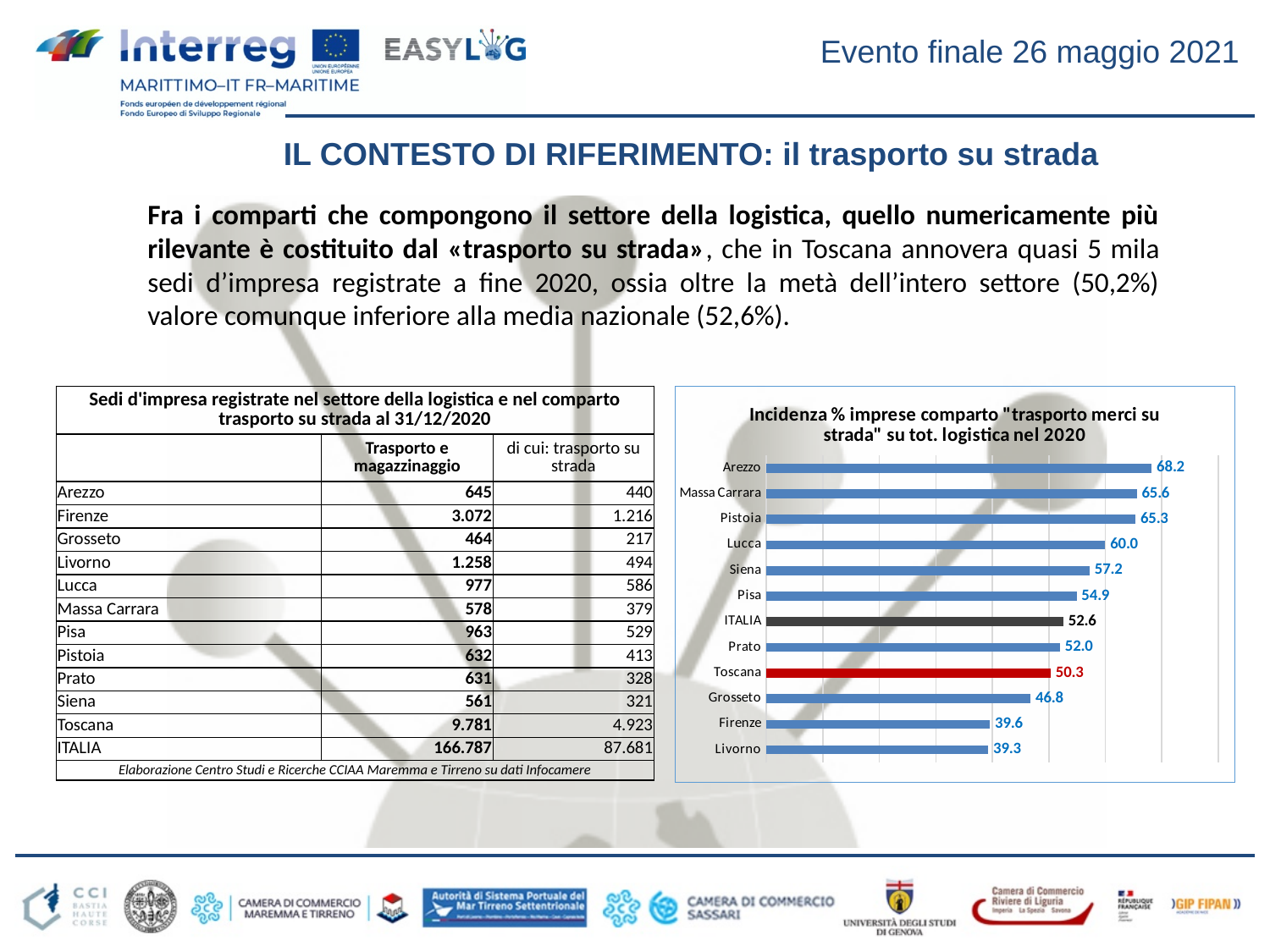
What is the value for ITALIA in the chart? 52.6 What is the difference between the values for Arezzo and Livorno? 28.9 What is the difference between the values for ITALIA and Toscana? 2.3 What type of chart is shown on the slide? bar chart What is the value for Arezzo in the chart? 68.2 Which category has the lowest value in the chart? Livorno How many categories are plotted in the chart? 12 Which has a larger value, Lucca or Grosseto? Lucca Which category has the highest value in the chart? Arezzo What is the value for Livorno in the chart? 39.3 What is the value for Toscana in the chart? 50.3 What is the title of the chart? Incidenza % imprese comparto "trasporto merci su strada" su tot. logistica nel 2020